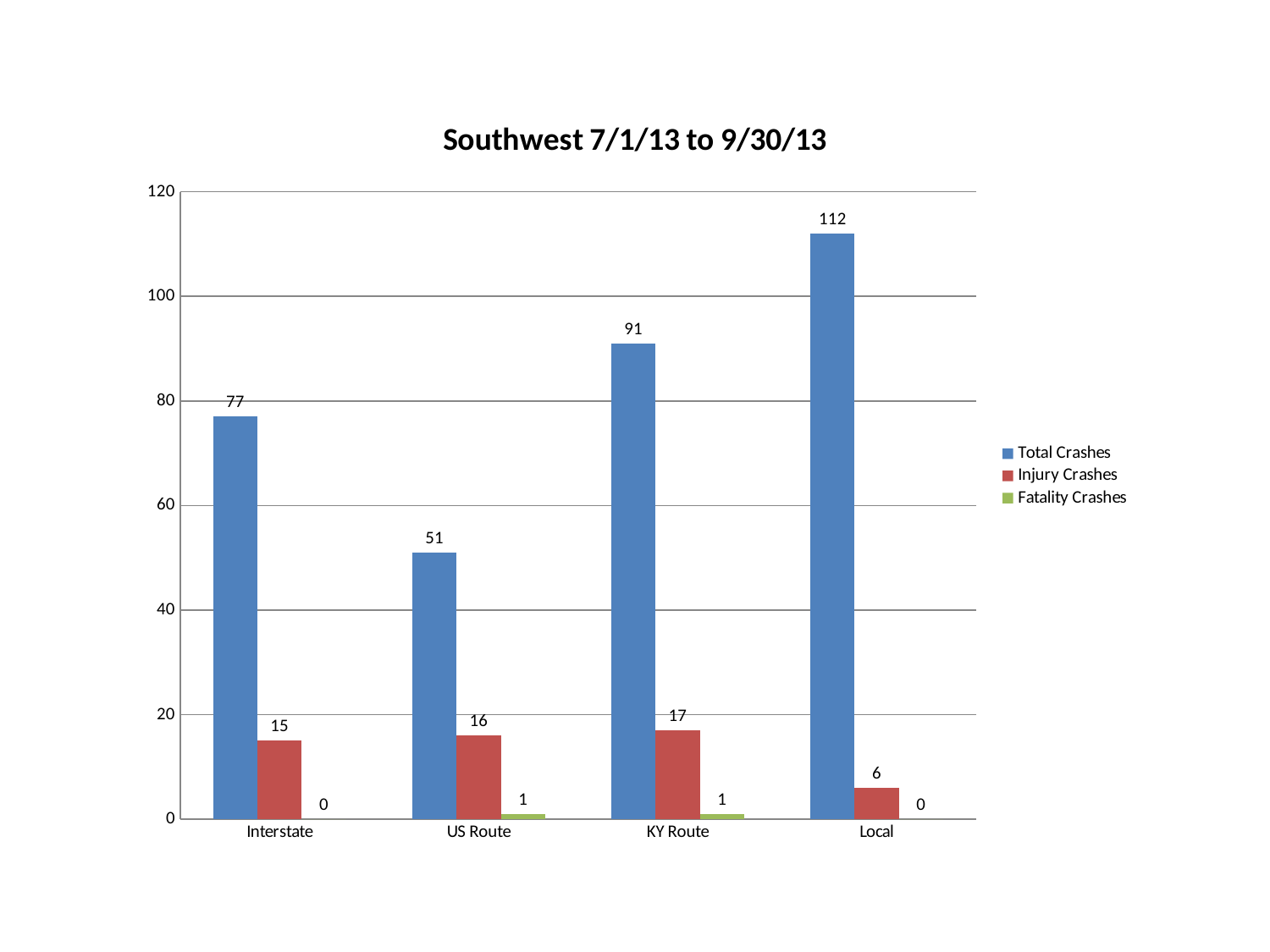
What is the value of Fatality Crashes for US Route? 1 What is the value of Total Crashes for Local? 112 Which is larger, Injury Crashes for Interstate or Injury Crashes for US Route? US Route Which category has the lowest Total Crashes? US Route How many categories are shown on the x axis? 4 How many series does the legend list? 3 What is the title of the chart? Southwest 7/1/13 to 9/30/13 What is the value of Injury Crashes for KY Route? 17 Which category has the highest Total Crashes? Local What is the difference in Total Crashes between Local and KY Route? 21 What kind of chart is shown on the slide? bar chart Is the value of Total Crashes for Interstate greater or less than 80? less